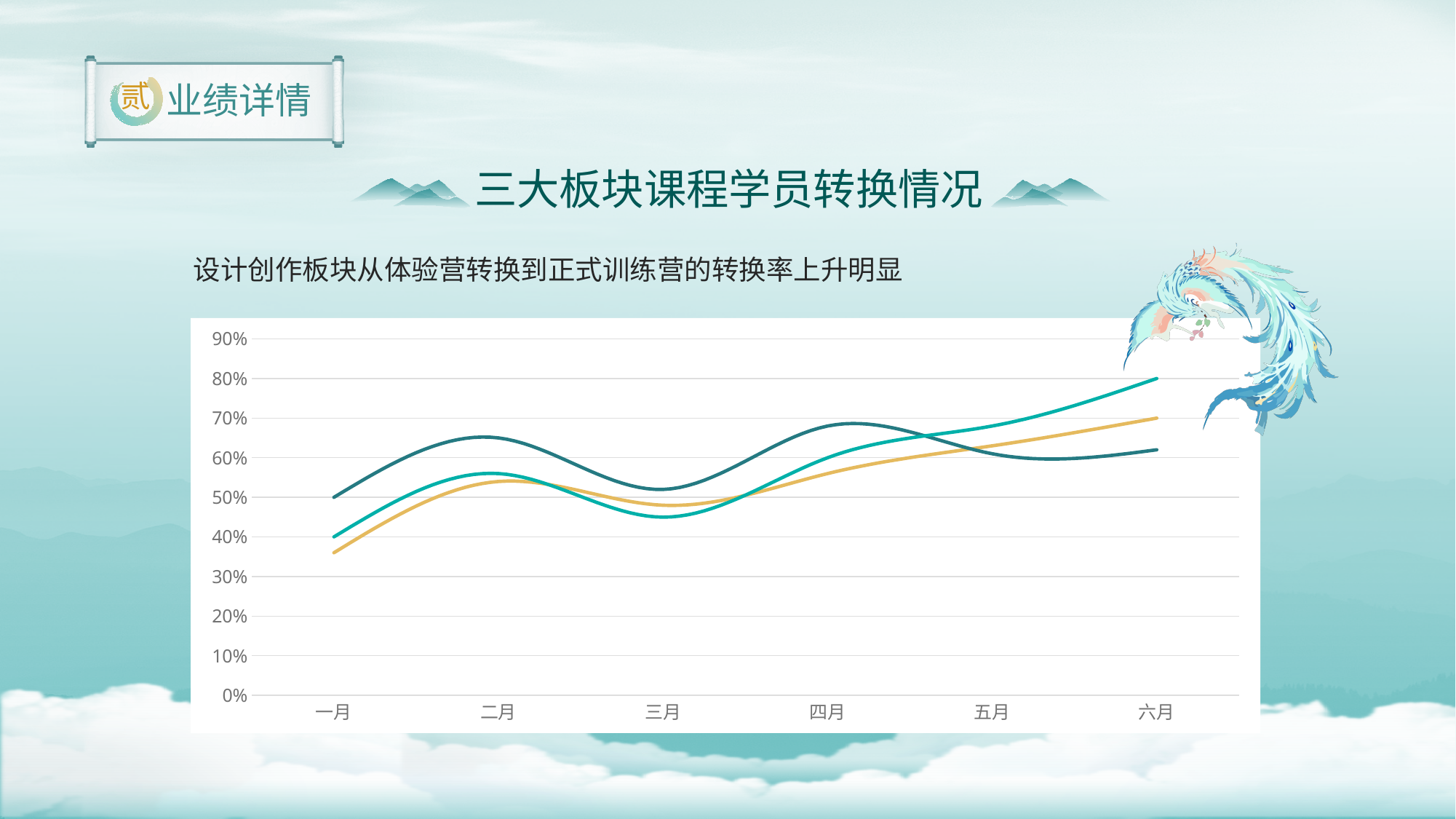
What is the highest value shown on the y axis? 90% Is the value of the bright teal line in 六月 greater or less than 70%? greater What is the first month shown on the x axis? 一月 How many months are shown on the x axis of the chart? 6 Does the gold line rise or fall from 四月 to 六月? rise Which line has the lowest value in 一月? the gold line Is the value of the dark teal line in 二月 greater or less than 60%? greater How many lines are plotted on the chart? 3 Is the value of the bright teal line in 三月 greater or less than 50%? less What kind of chart is shown on the slide? line chart Which line has the highest value in 六月? the bright teal line